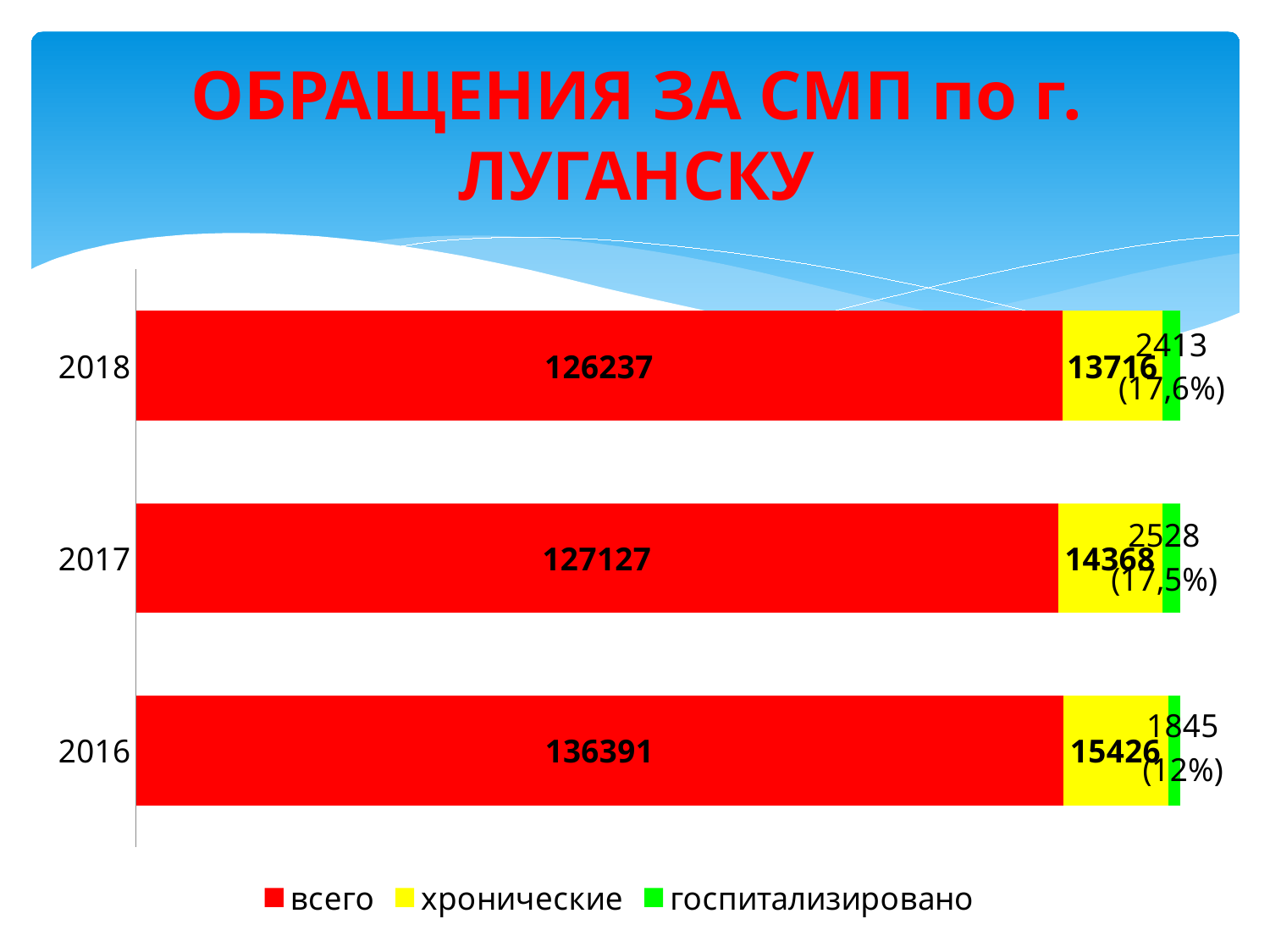
How many series does the legend list? 3 What is the total of the stacked bar for 2018? 142366 Which year has the highest value for всего? 2016 Which year has the highest value for госпитализировано? 2017 How many years are shown on the chart? 3 What kind of chart is shown on the slide? stacked bar chart What is the difference between the всего values for 2016 and 2018? 10154 Which year has the lowest value for хронические? 2018 What is the value of госпитализировано for 2016? 1845 What is the value of хронические for 2017? 14368 What is the value of всего for 2018? 126237 Is the всего value for 2017 larger or smaller than the всего value for 2018? larger